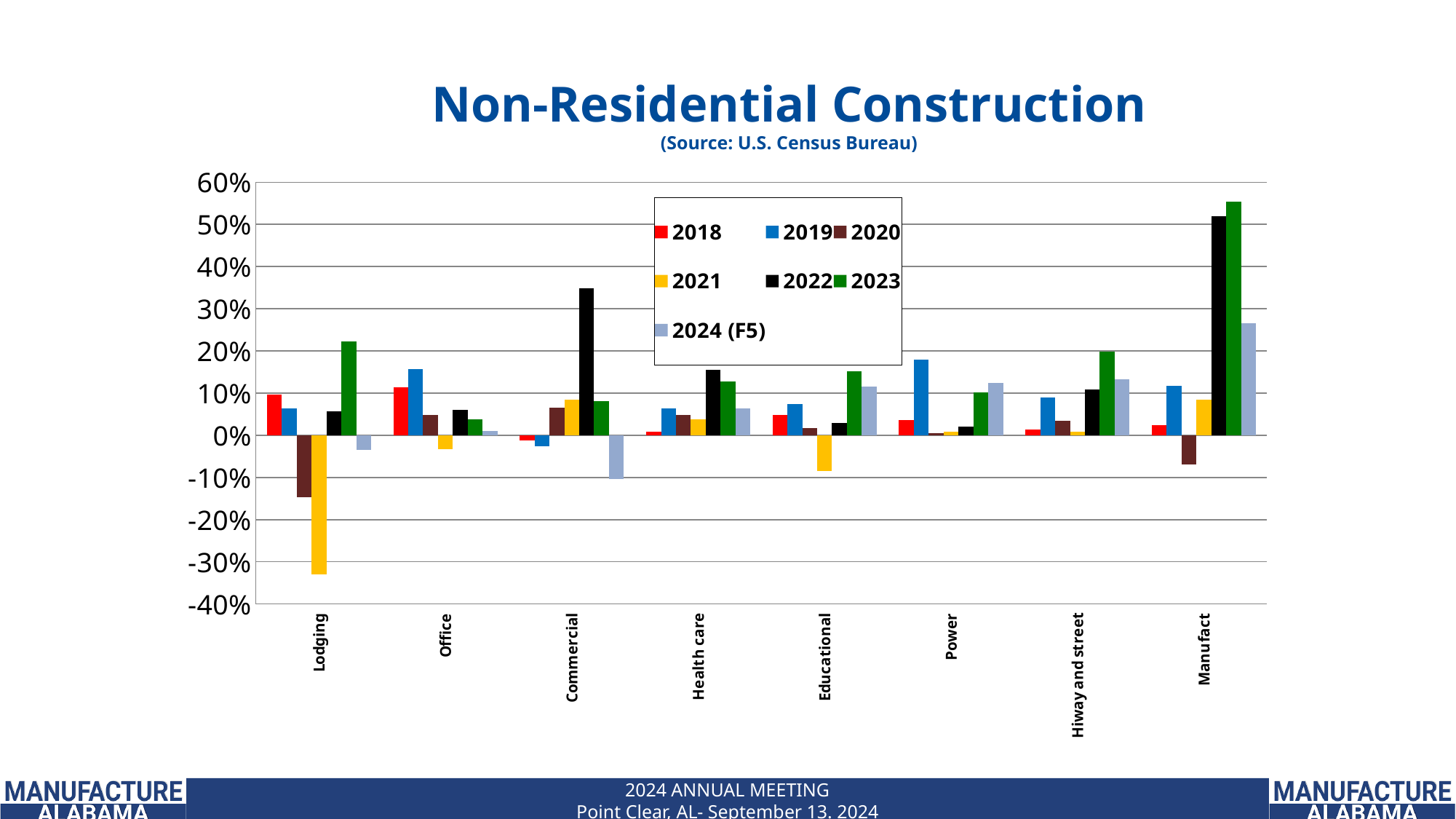
Is the 2023 value for Manufact greater or less than 50%? greater Which is larger, the 2022 value for Commercial or the 2022 value for Health care? Commercial Is the 2021 value for Lodging greater or less than -30%? less Which category has the lowest value for the 2021 series? Lodging What kind of chart is shown on the slide? Bar chart Which is larger, the 2023 value for Lodging or the 2023 value for Office? Lodging Is the 2022 value for Commercial greater or less than 30%? greater How many series does the legend list? 7 How many categories are shown along the x axis of the chart? 8 Which category has the highest value for the 2022 series? Manufact Which category has the highest value for the 2023 series? Manufact What source is cited under the chart title? U.S. Census Bureau